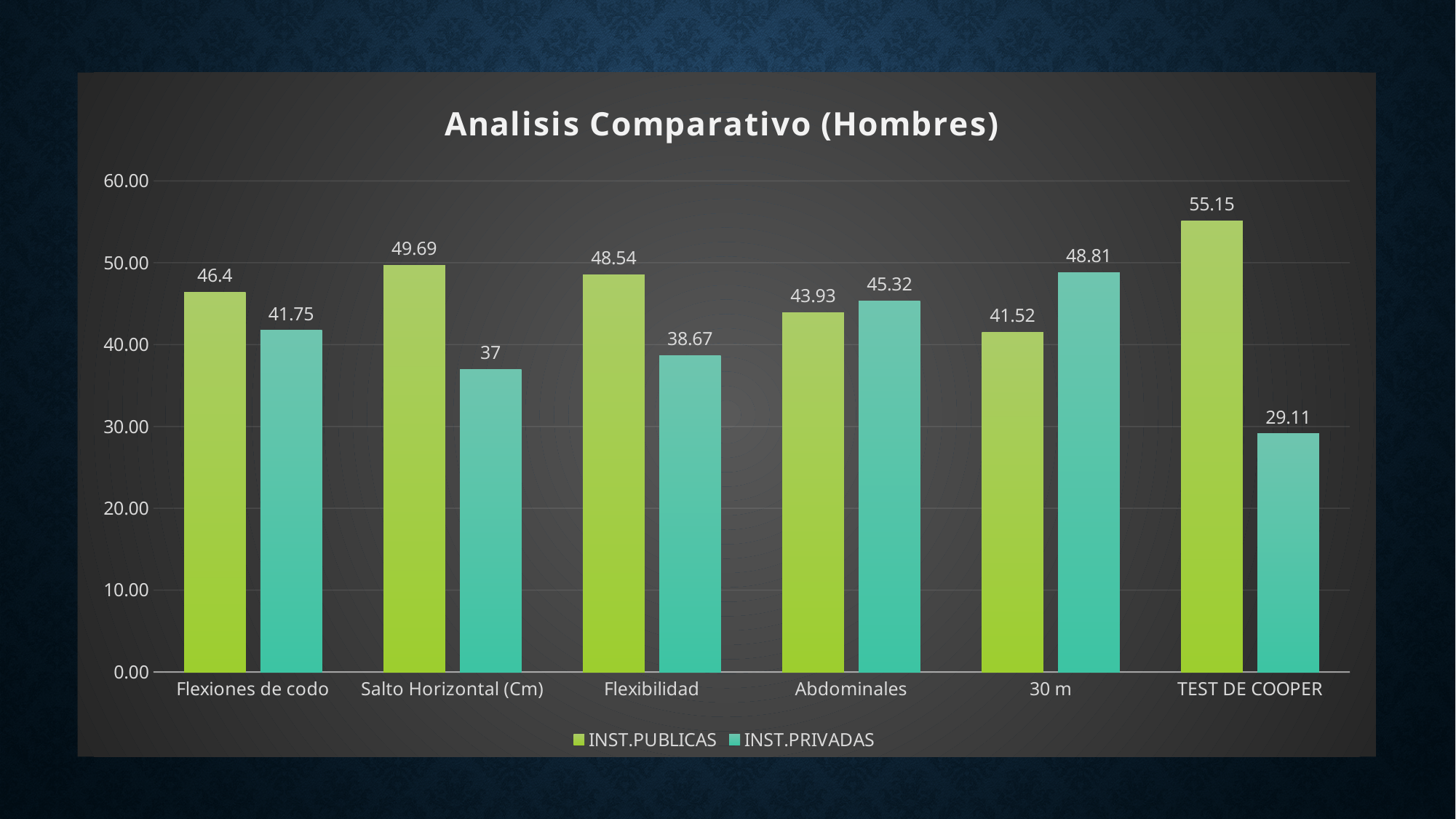
How many series does the legend list? 2 What is the INST.PRIVADAS value for Salto Horizontal (Cm)? 37 Which category has the lowest INST.PRIVADAS value? TEST DE COOPER What is the title of the chart? Analisis Comparativo (Hombres) Is the INST.PRIVADAS value for Flexibilidad greater or less than 40.00? less What is the INST.PRIVADAS value for TEST DE COOPER? 29.11 For 30 m, which series has the larger value, INST.PUBLICAS or INST.PRIVADAS? INST.PRIVADAS What kind of chart is shown on the slide? bar chart What is the INST.PUBLICAS value for Flexiones de codo? 46.4 What is the difference between the INST.PUBLICAS and INST.PRIVADAS values for TEST DE COOPER? 26.04 How many categories are shown on the x axis? 6 Which category has the highest INST.PUBLICAS value? TEST DE COOPER